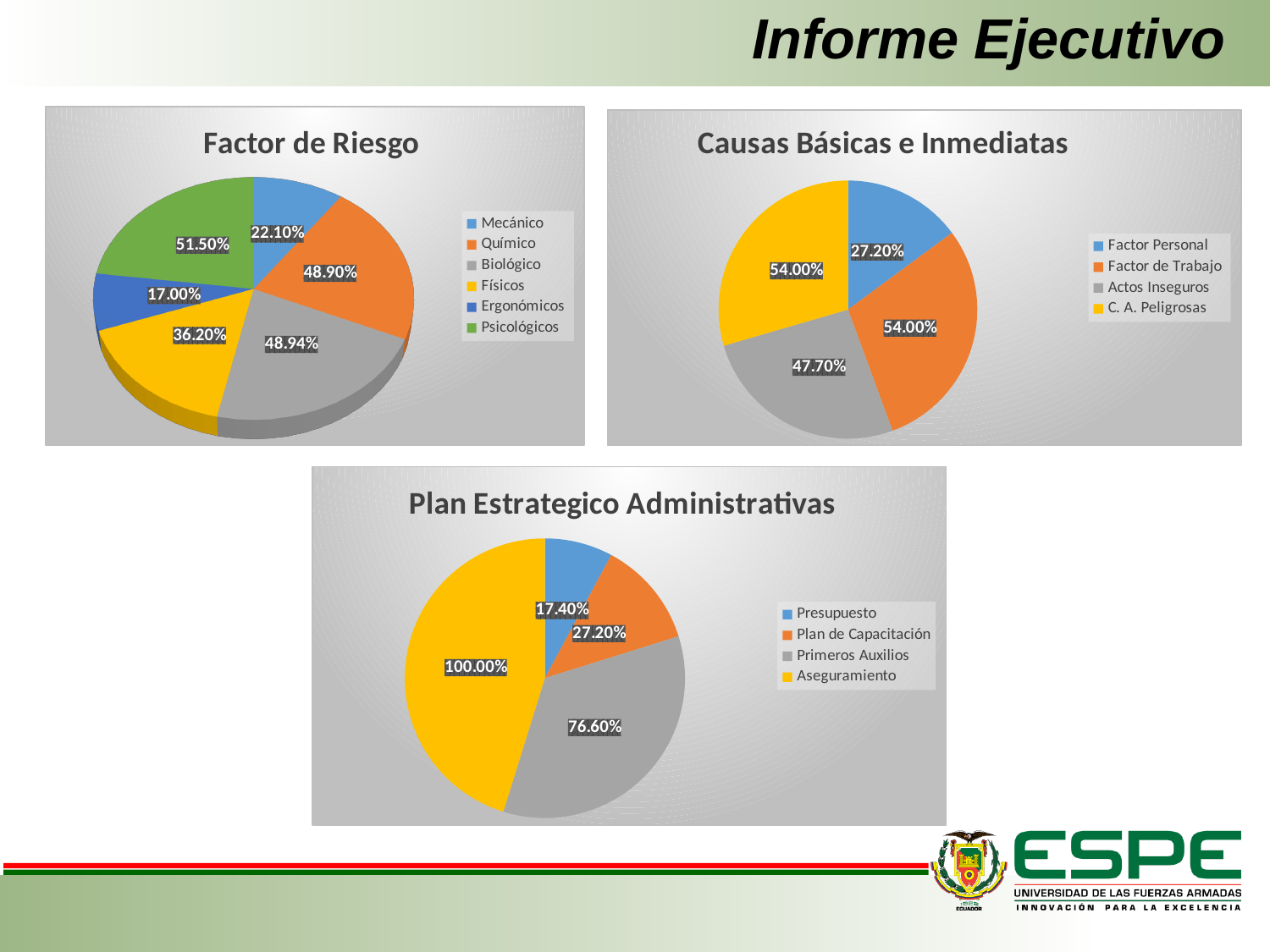
How many categories does the 'Factor de Riesgo' chart show? 6 In the 'Causas Básicas e Inmediatas' chart, what is the value for Actos Inseguros? 47.70% In the 'Plan Estrategico Administrativas' chart, what is the difference between Aseguramiento and Primeros Auxilios? 23.40% In the 'Plan Estrategico Administrativas' chart, what is the value for Primeros Auxilios? 76.60% In the 'Causas Básicas e Inmediatas' chart, which category has the lowest value? Factor Personal In the 'Factor de Riesgo' chart, which category has the lowest value? Ergonómicos How many entries does the legend of the 'Causas Básicas e Inmediatas' chart list? 4 In the 'Factor de Riesgo' chart, what is the value for Psicológicos? 51.50% In the 'Plan Estrategico Administrativas' chart, which category has the highest value? Aseguramiento What type of chart is 'Plan Estrategico Administrativas'? Pie chart In the 'Causas Básicas e Inmediatas' chart, what is the difference between Factor de Trabajo and Actos Inseguros? 6.30% In the 'Factor de Riesgo' chart, which category has the highest value? Psicológicos